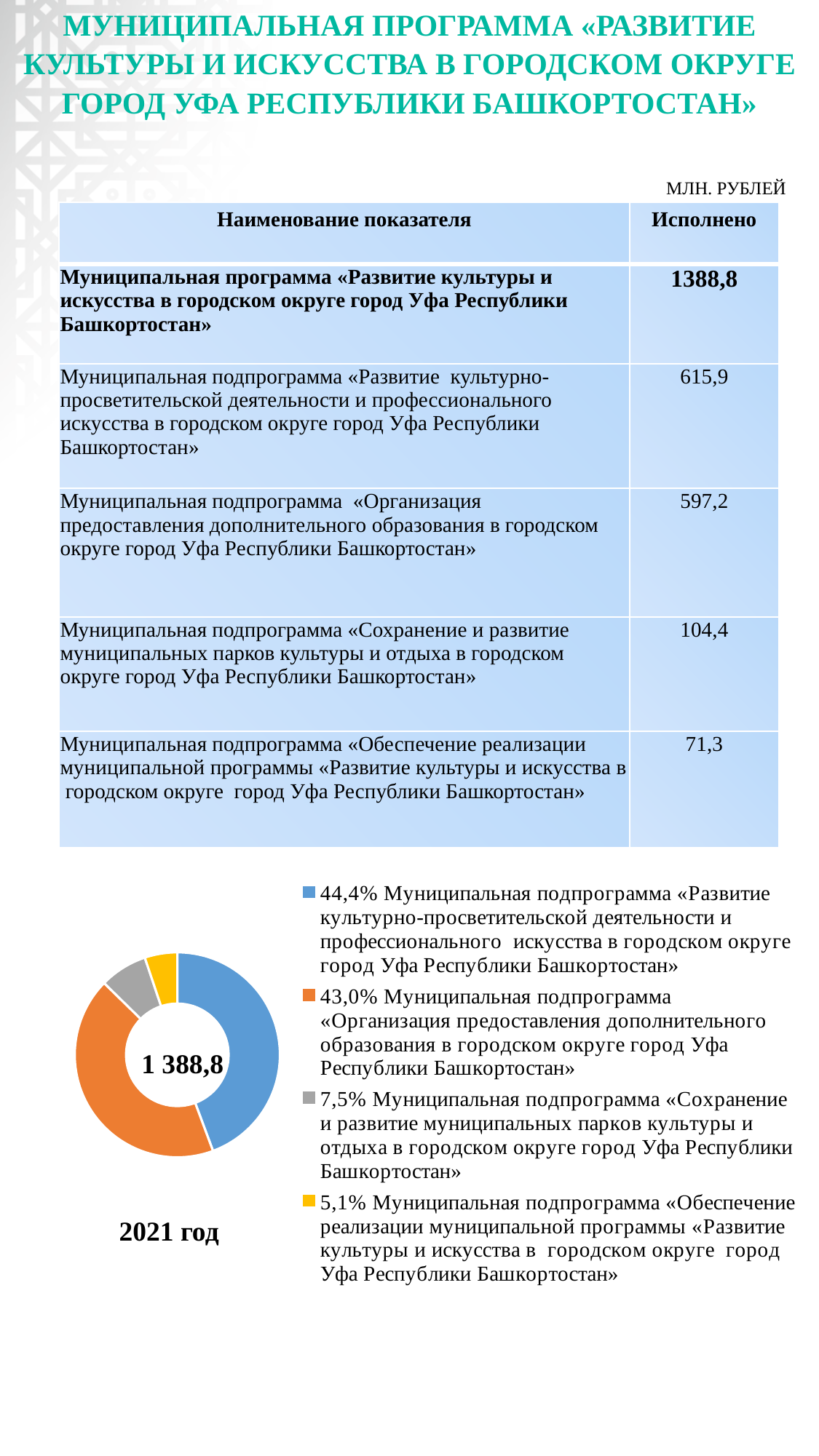
What total value is printed in the centre of the doughnut chart? 1 388,8 What share of the doughnut chart does the subprogramme «Обеспечение реализации муниципальной программы» take? 5,1% Which subprogramme has the largest slice in the doughnut chart? «Развитие культурно-просветительской деятельности и профессионального искусства» (44,4%) What kind of chart is shown at the bottom of the slide? Doughnut (pie) chart What share of the doughnut chart does the subprogramme «Организация предоставления дополнительного образования» take? 43,0% What year is labelled under the doughnut chart? 2021 год How many slices does the doughnut chart have? 4 Which subprogramme has the smallest slice in the doughnut chart? «Обеспечение реализации муниципальной программы» (5,1%) What is the difference in percentage points between the 44,4% slice and the 43,0% slice in the doughnut chart? 1,4 percentage points Which is larger in the doughnut chart: the share for parks (grey) or the share for programme implementation (yellow)? Parks (7,5%) What share of the doughnut chart does the subprogramme «Сохранение и развитие муниципальных парков культуры и отдыха» take? 7,5%